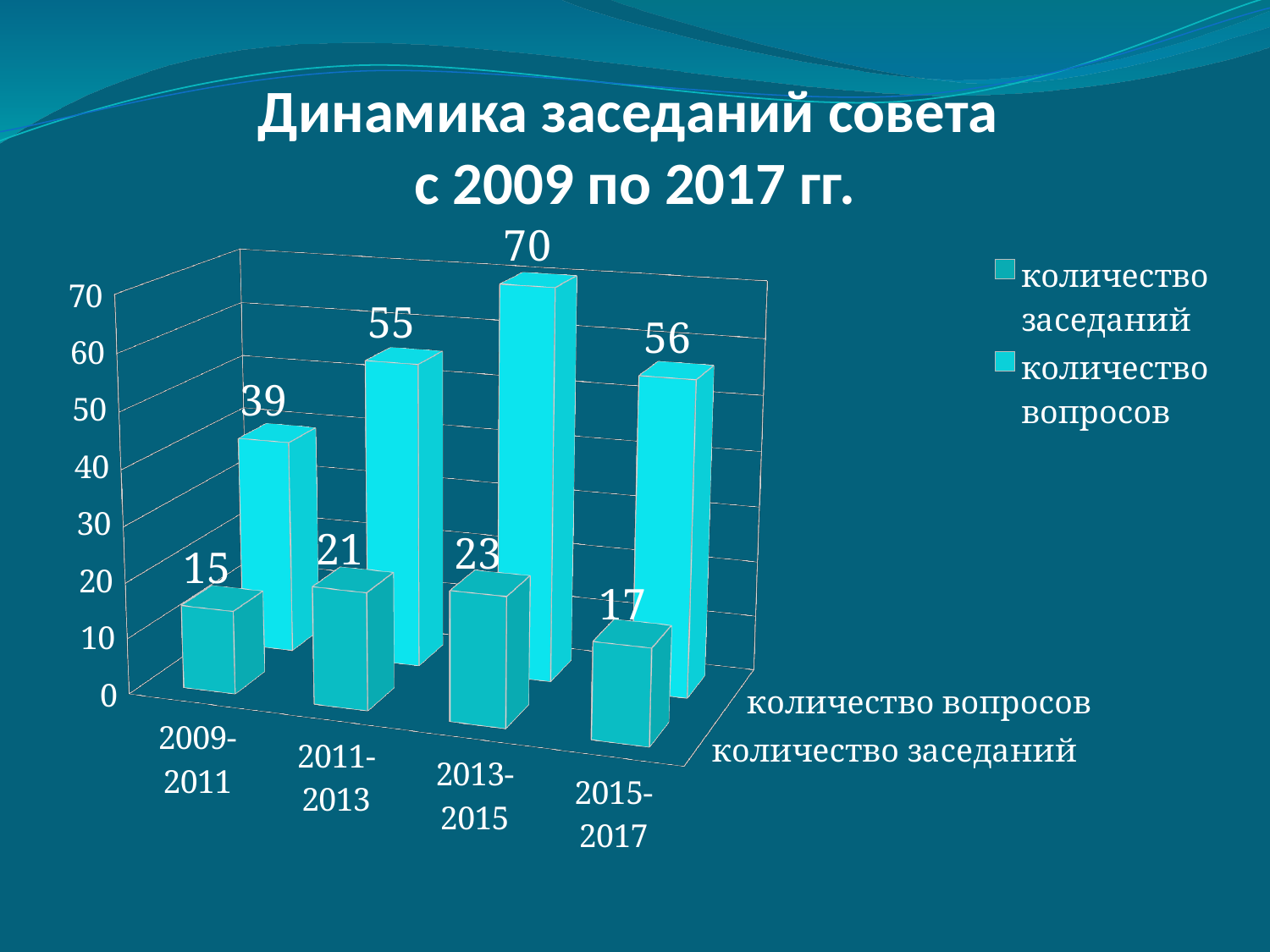
How many series does the legend list? 2 What is the value of количество вопросов for 2011-2013? 55 Which is larger: количество заседаний for 2011-2013 or for 2013-2015? 2013-2015 What kind of chart is shown on the slide? bar chart What is the title of the chart on the slide? Динамика заседаний совета с 2009 по 2017 гг. Which period has the lowest value for количество заседаний? 2009-2011 Which period has the highest value for количество вопросов? 2013-2015 What is the difference between количество вопросов for 2013-2015 and for 2009-2011? 31 What is the value of количество заседаний for 2009-2011? 15 How many periods are shown on the x axis? 4 What is the value of количество заседаний for 2015-2017? 17 What is the value of количество вопросов for 2013-2015? 70